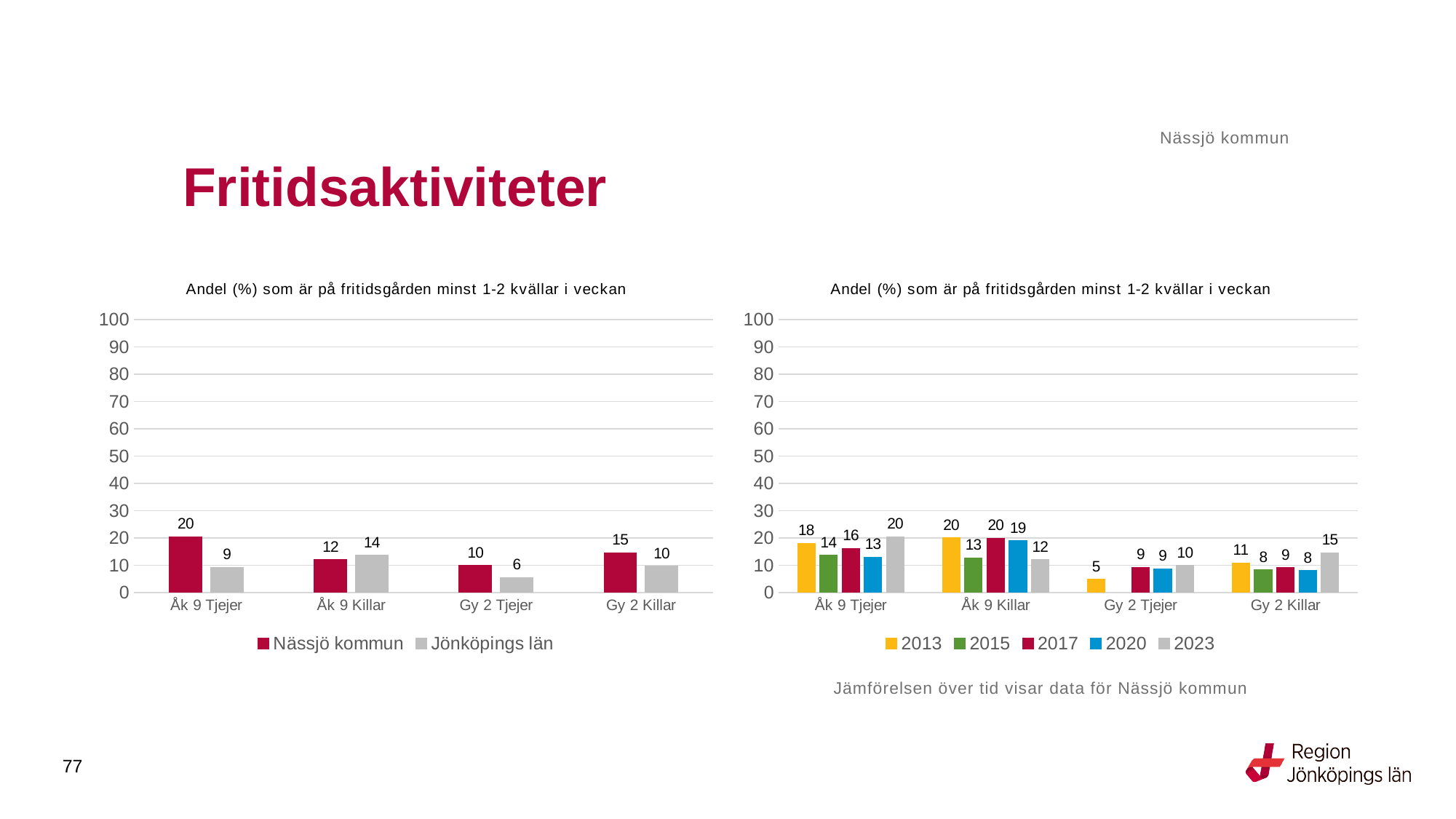
In the left chart, what is the difference between Nässjö kommun and Jönköpings län for Åk 9 Tjejer? 11 In the right chart, what is the value for 2013 for Gy 2 Tjejer? 5 In the left chart, which is larger for Åk 9 Killar: Nässjö kommun or Jönköpings län? Jönköpings län In the left chart, what is the value for Nässjö kommun for Åk 9 Tjejer? 20 How many series does the legend of the left chart list? 2 In the right chart, what is the value for 2023 for Gy 2 Killar? 15 In the right chart, what is the difference between 2013 and 2023 for Åk 9 Killar? 8 In the left chart, which category has the lowest value for Jönköpings län? Gy 2 Tjejer In the right chart, which year has the highest value for Åk 9 Tjejer? 2023 In the left chart, what is the value for Jönköpings län for Gy 2 Tjejer? 6 What kind of chart is the right chart? Bar chart How many series does the legend of the right chart list? 5